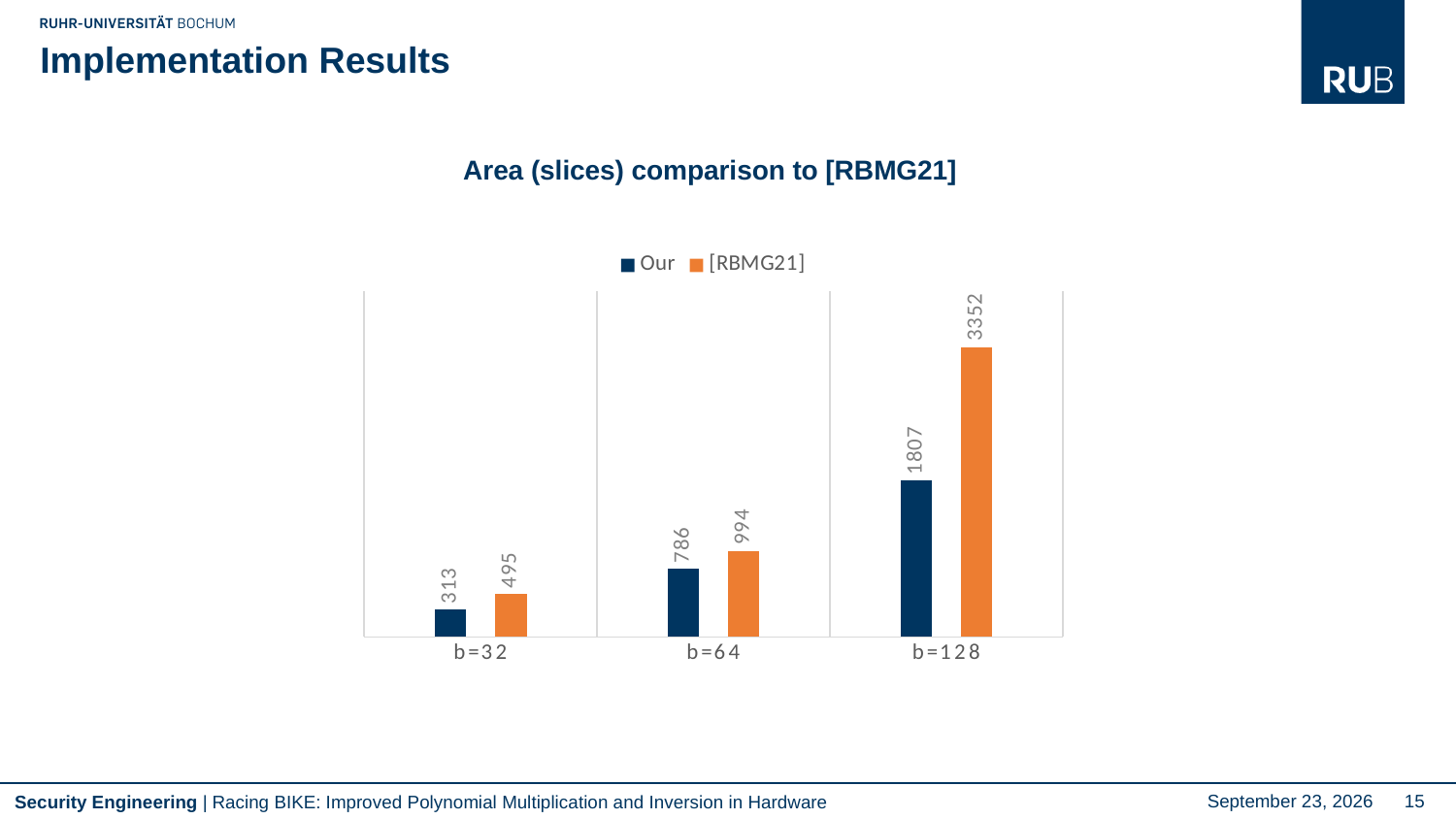
What is the value for Our at b=64? 786 What is the value for [RBMG21] at b=64? 994 What is the value for [RBMG21] at b=128? 3352 How many categories are shown on the x axis? 3 Which is larger at b=64, Our or [RBMG21]? [RBMG21] What is the difference between the [RBMG21] and Our values at b=128? 1545 Which category has the lowest value for the [RBMG21] series? b=32 What kind of chart is shown on the slide? Bar chart Which category has the highest value for the Our series? b=128 What is the value for Our at b=32? 313 What is the difference between the [RBMG21] and Our values at b=32? 182 How many series does the legend list? 2